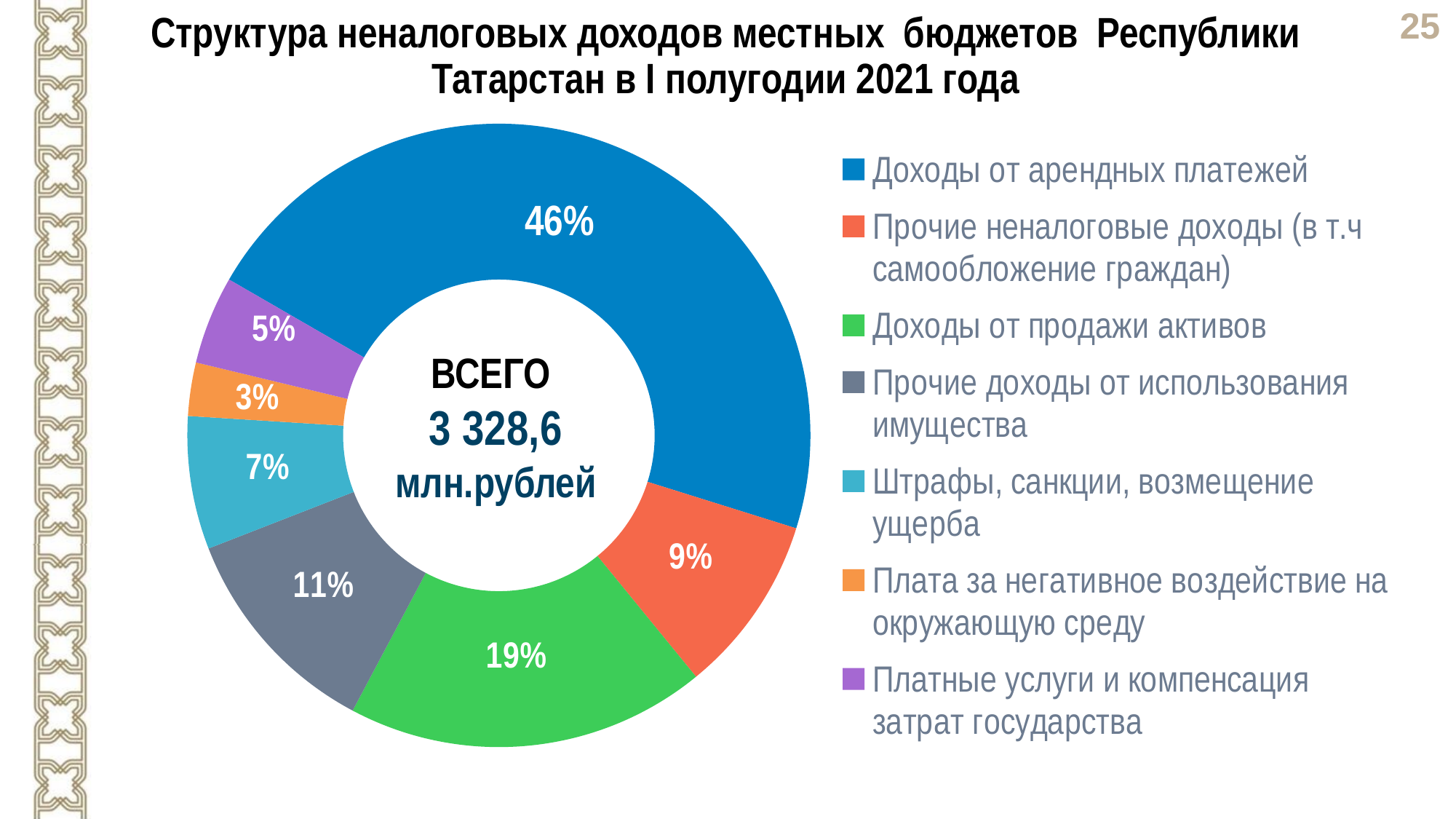
What share of the chart is "Доходы от продажи активов"? 19% What kind of chart is shown on the slide? Doughnut (pie) chart What percentage is shown for "Прочие доходы от использования имущества"? 11% What percentage is shown for "Плата за негативное воздействие на окружающую среду"? 3% Which category has the smallest share of the chart? Плата за негативное воздействие на окружающую среду What is the difference in percentage points between "Доходы от арендных платежей" and "Доходы от продажи активов"? 27 percentage points What percentage is shown for "Штрафы, санкции, возмещение ущерба"? 7% How many categories does the legend list? 7 What share of non-tax revenues comes from "Доходы от арендных платежей"? 46% Which is larger: the share of "Прочие неналоговые доходы (в т.ч самообложение граждан)" or the share of "Платные услуги и компенсация затрат государства"? Прочие неналоговые доходы (в т.ч самообложение граждан) Which category has the largest share of the chart? Доходы от арендных платежей What total value is shown in the centre of the chart? 3 328,6 млн.рублей